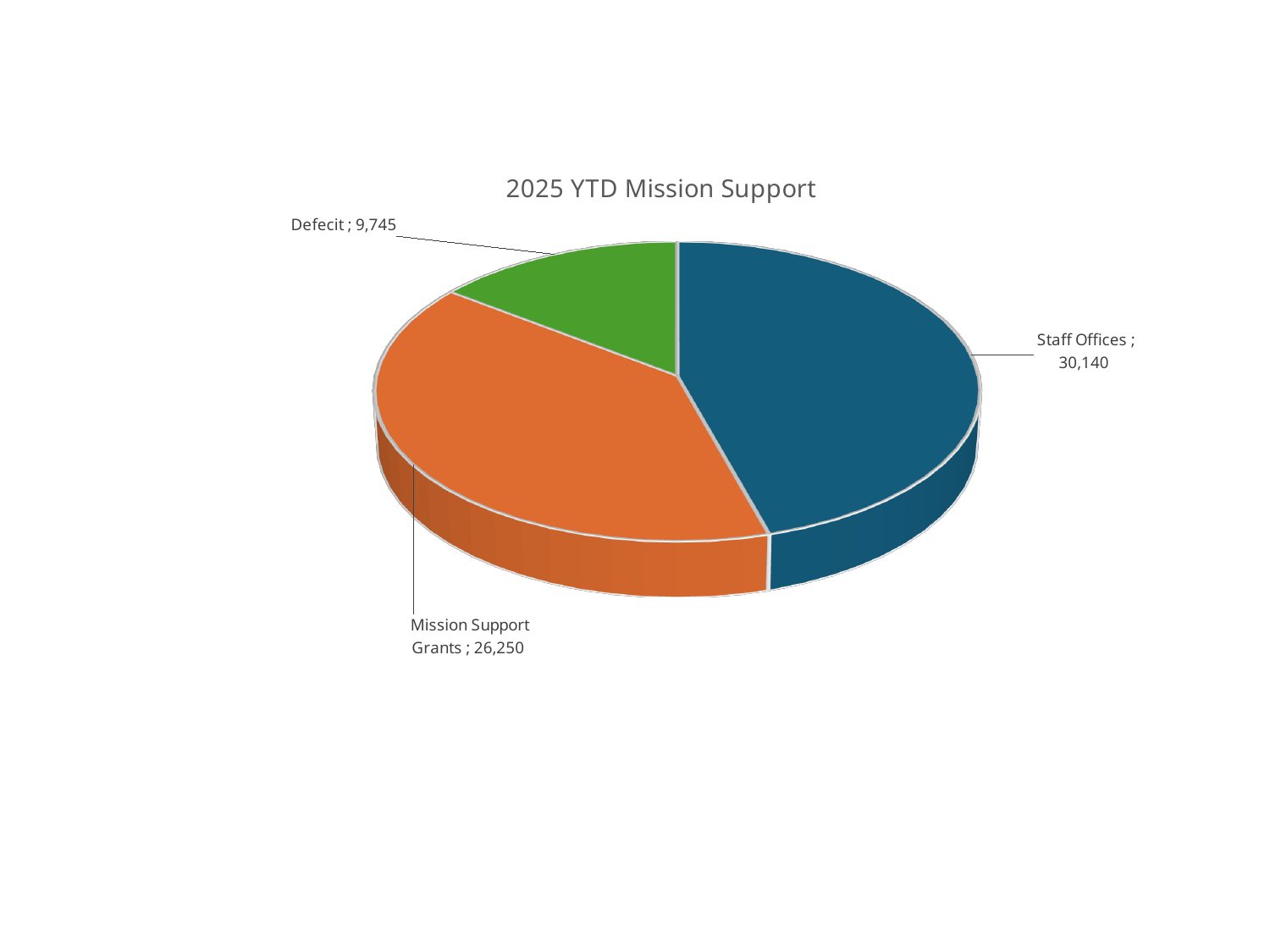
Which category has the largest slice of the pie? Staff Offices What is the value for Defecit? 9,745 What is the value for Mission Support Grants? 26,250 Which is larger, Mission Support Grants or Defecit? Mission Support Grants What is the difference between the Staff Offices value and the Mission Support Grants value? 3,890 What is the value for Staff Offices? 30,140 What kind of chart is shown on the slide? Pie chart What colour is the Defecit slice? Green What is the title of the chart? 2025 YTD Mission Support Which category has the smallest slice of the pie? Defecit What is the difference between the Mission Support Grants value and the Defecit value? 16,505 How many slices does the pie chart have? 3